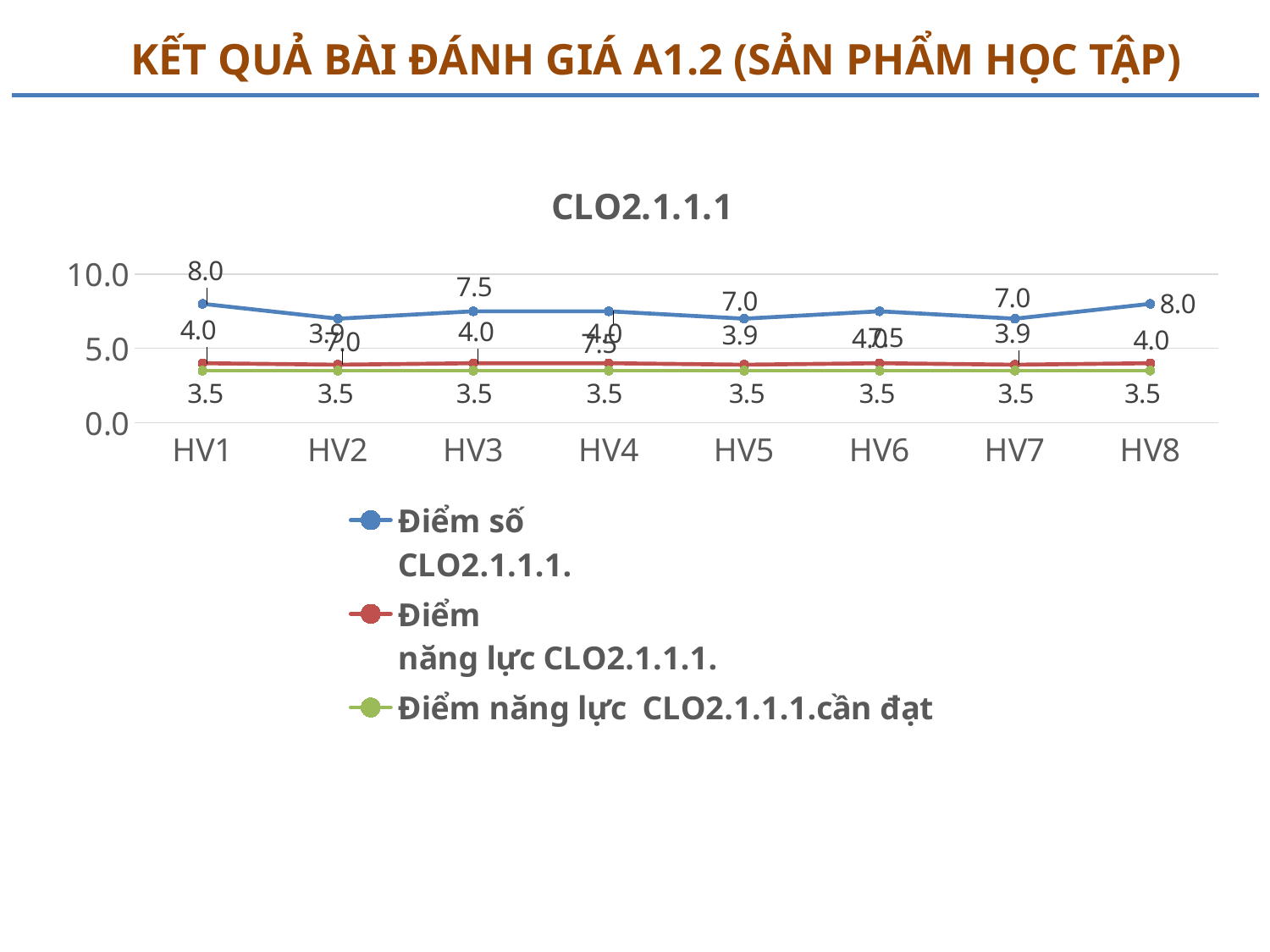
What is the Điểm số CLO2.1.1.1. value for HV3? 7.5 Is the Điểm số CLO2.1.1.1. value for HV8 greater or less than 5.0? greater Which is larger for HV7: the Điểm số CLO2.1.1.1. value or the Điểm năng lực CLO2.1.1.1. value? Điểm số CLO2.1.1.1. What is the difference between the Điểm số CLO2.1.1.1. values for HV1 and HV5? 1.0 What type of chart is shown on the slide? line chart What is the difference between the Điểm năng lực CLO2.1.1.1. value and the Điểm năng lực CLO2.1.1.1.cần đạt value for HV1? 0.5 What is the title of the chart? CLO2.1.1.1 What is the Điểm số CLO2.1.1.1. value for HV1? 8.0 What is the Điểm năng lực CLO2.1.1.1. value for HV5? 3.9 What is the Điểm năng lực CLO2.1.1.1.cần đạt value for HV8? 3.5 How many categories (HV) are shown on the x axis? 8 How many series does the legend list? 3